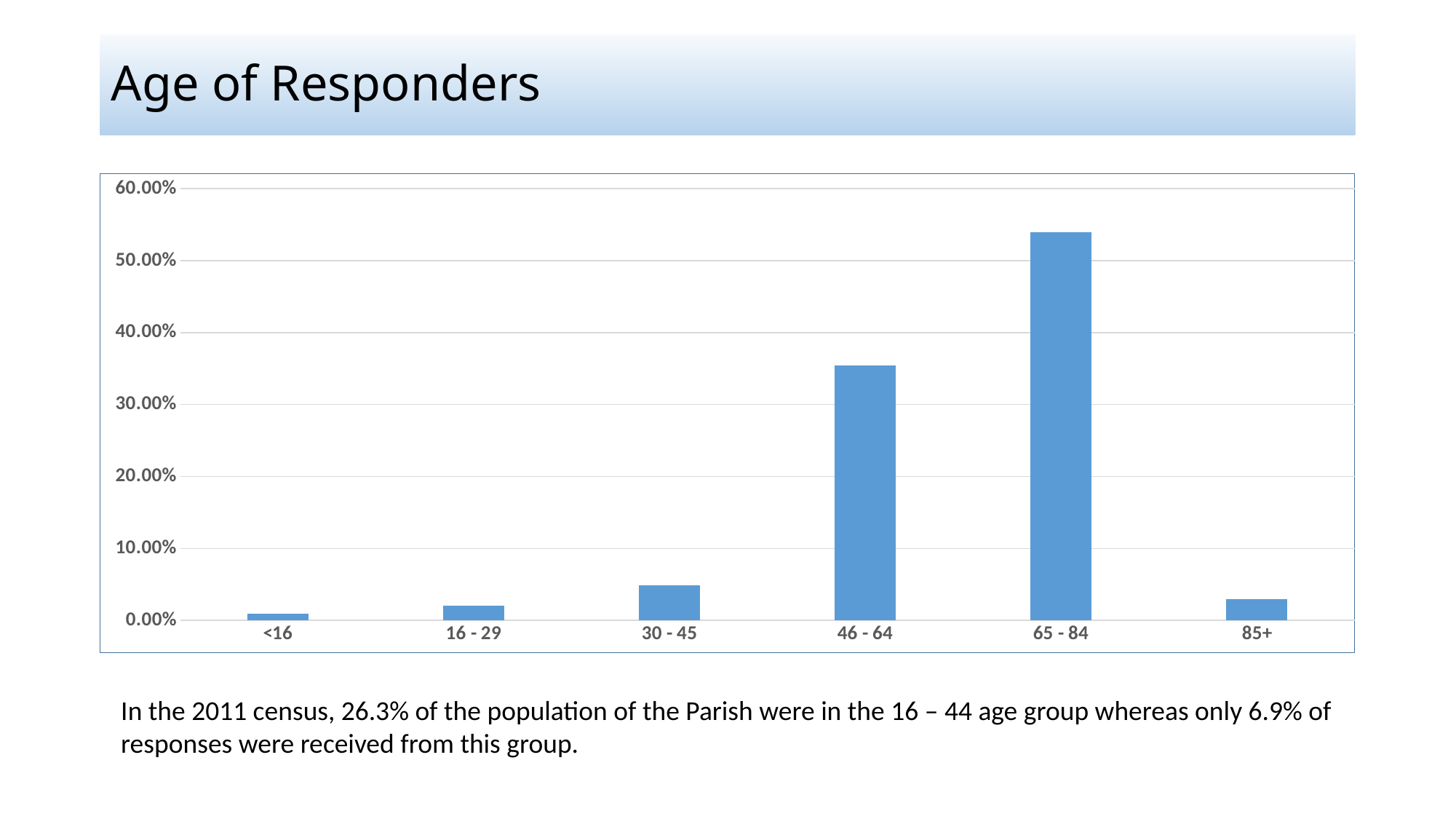
Is the value for the 30 - 45 age group greater or less than 10.00%? less What is the highest value shown on the y axis of the chart? 60.00% Is the value for the 85+ age group greater or less than 10.00%? less Is the value for the 65 - 84 age group greater or less than 50.00%? greater How many age groups are shown on the x axis of the chart? 6 Which has the larger value, the 30 - 45 age group or the 85+ age group? 30 - 45 What kind of chart is shown on the slide? bar chart Which age group has the highest value in the chart? 65 - 84 Which has the larger value, the 46 - 64 age group or the 65 - 84 age group? 65 - 84 Which age group has the lowest value in the chart? <16